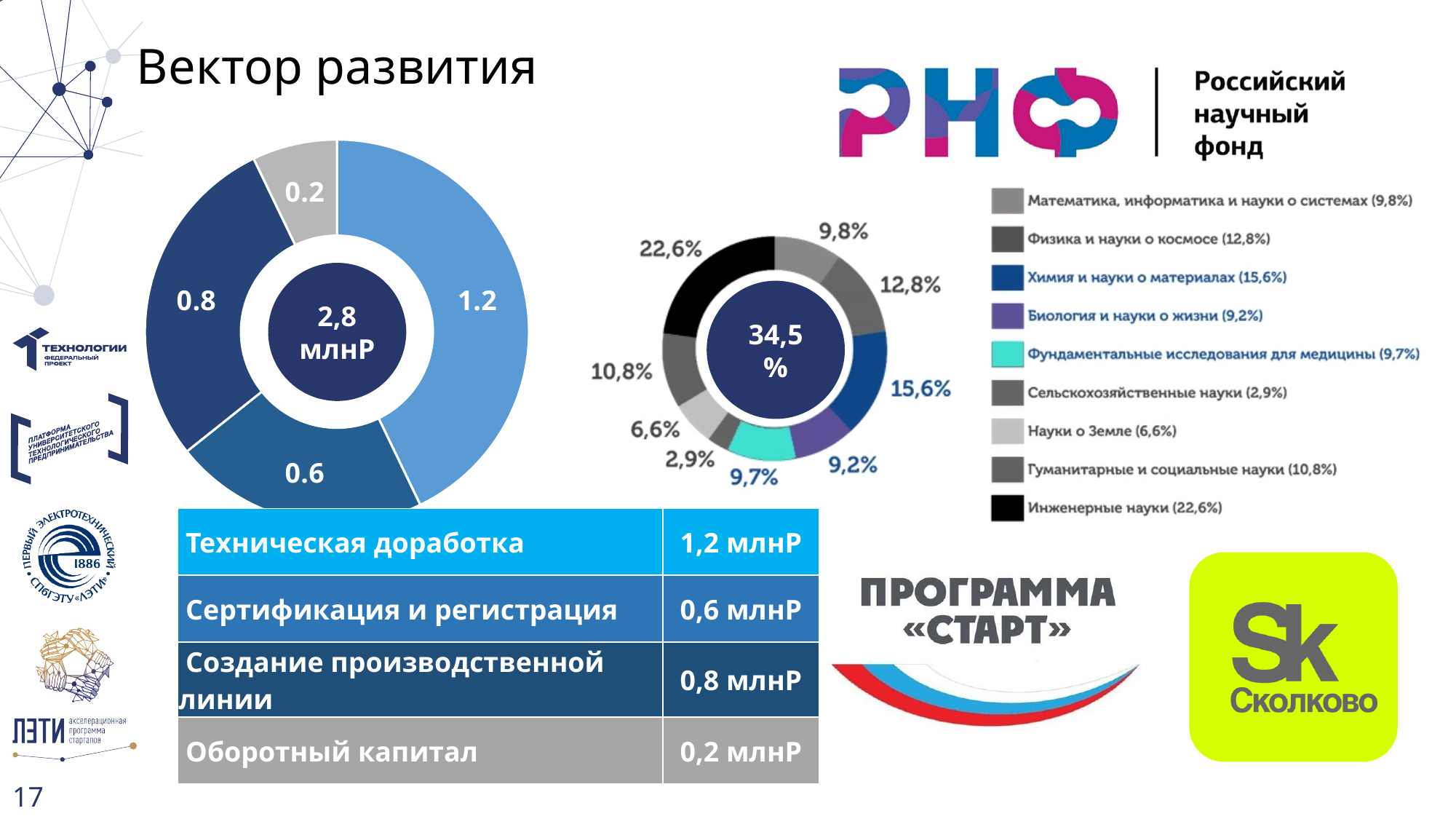
On the right donut chart (Российский научный фонд), which is larger: Физика и науки о космосе or Гуманитарные и социальные науки? Физика и науки о космосе What kind of chart is the left chart showing 2,8 млнР? Donut (pie) chart On the left donut chart, what total value is shown in the centre? 2,8 млнР On the left donut chart, what is the value of the smallest segment? 0.2 On the left donut chart, how many segments are there? 4 According to the table under the left donut chart, how much is allocated to Сертификация и регистрация? 0,6 млнР On the left donut chart, what is the difference between the 1.2 segment and the 0.8 segment? 0.4 On the left donut chart, what is the value of the largest segment? 1.2 On the right donut chart (Российский научный фонд), what is the share for Химия и науки о материалах? 15,6% On the right donut chart (Российский научный фонд), which category has the largest share? Инженерные науки (22,6%) On the right donut chart (Российский научный фонд), how many categories does the legend list? 9 On the right donut chart (Российский научный фонд), which category has the smallest share? Сельскохозяйственные науки (2,9%)